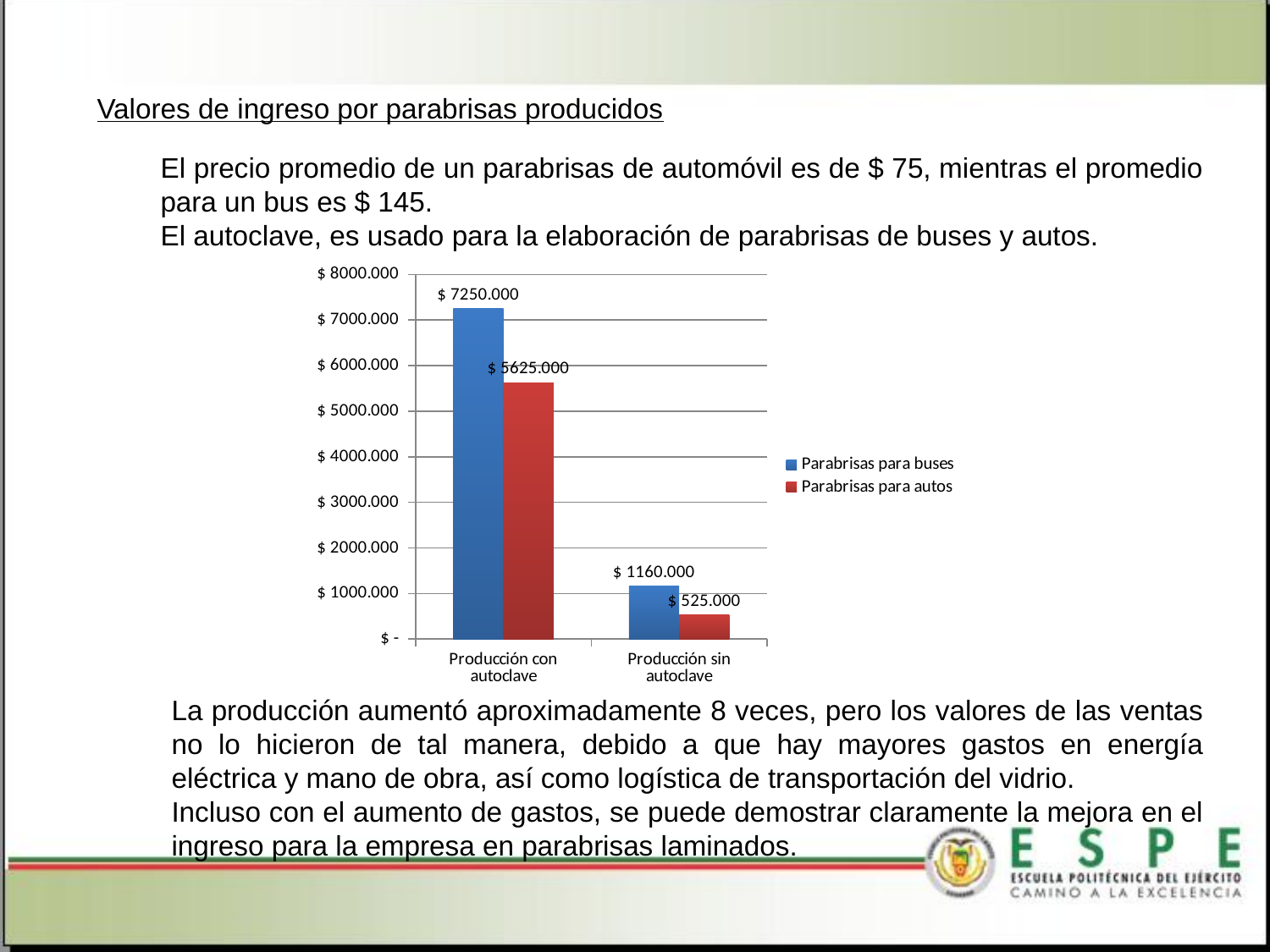
How many series does the chart legend list? 2 Which bar has the lowest value in the chart? Parabrisas para autos, Producción sin autoclave What is the value for Parabrisas para autos under Producción con autoclave? $ 5625.000 Which is larger: Parabrisas para autos under Producción con autoclave or Parabrisas para buses under Producción sin autoclave? Parabrisas para autos under Producción con autoclave What is the difference between Parabrisas para buses under Producción con autoclave and under Producción sin autoclave? $ 6090.000 What is the value for Parabrisas para buses under Producción sin autoclave? $ 1160.000 What is the value for Parabrisas para autos under Producción sin autoclave? $ 525.000 Which bar has the highest value in the chart? Parabrisas para buses, Producción con autoclave What is the difference between Parabrisas para buses and Parabrisas para autos under Producción con autoclave? $ 1625.000 How many categories are shown on the x axis of the chart? 2 What is the value for Parabrisas para buses under Producción con autoclave? $ 7250.000 What type of chart is shown on the slide? bar chart